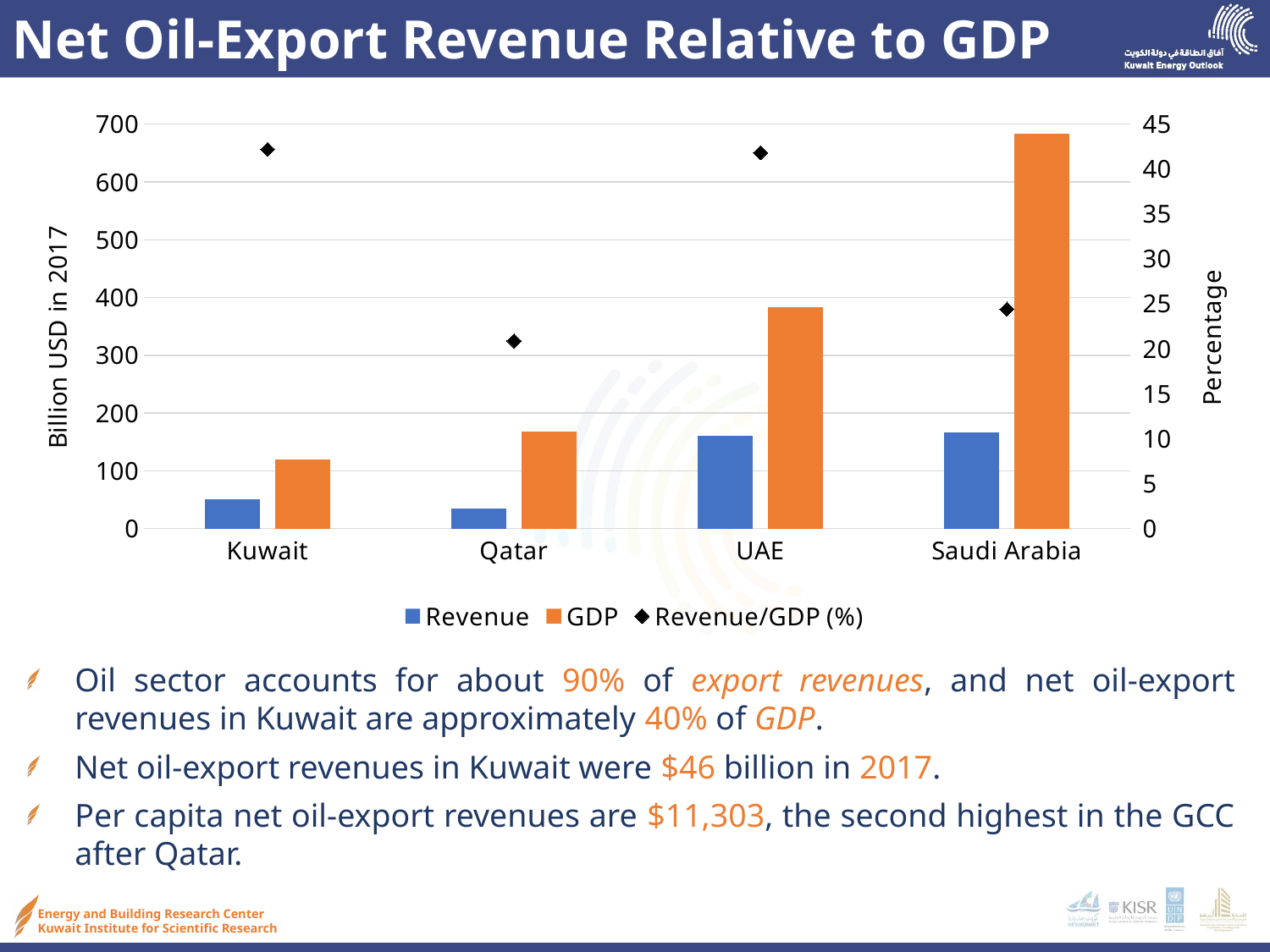
What kind of chart is used to plot the Revenue and GDP series? bar chart Which country has the lowest GDP bar? Kuwait What is the label on the left vertical axis? Billion USD in 2017 Which is larger, the Revenue for Kuwait or the Revenue for Qatar? Kuwait Which country has the highest GDP bar? Saudi Arabia Which country has the lowest Revenue bar? Qatar How many countries are shown on the x axis? 4 How many series does the legend list? 3 Is the GDP value for Saudi Arabia greater or less than 600? greater Is the GDP value for UAE greater or less than 300? greater Is the GDP value for Kuwait greater or less than 200? less Which country has the lowest Revenue/GDP (%) marker? Qatar